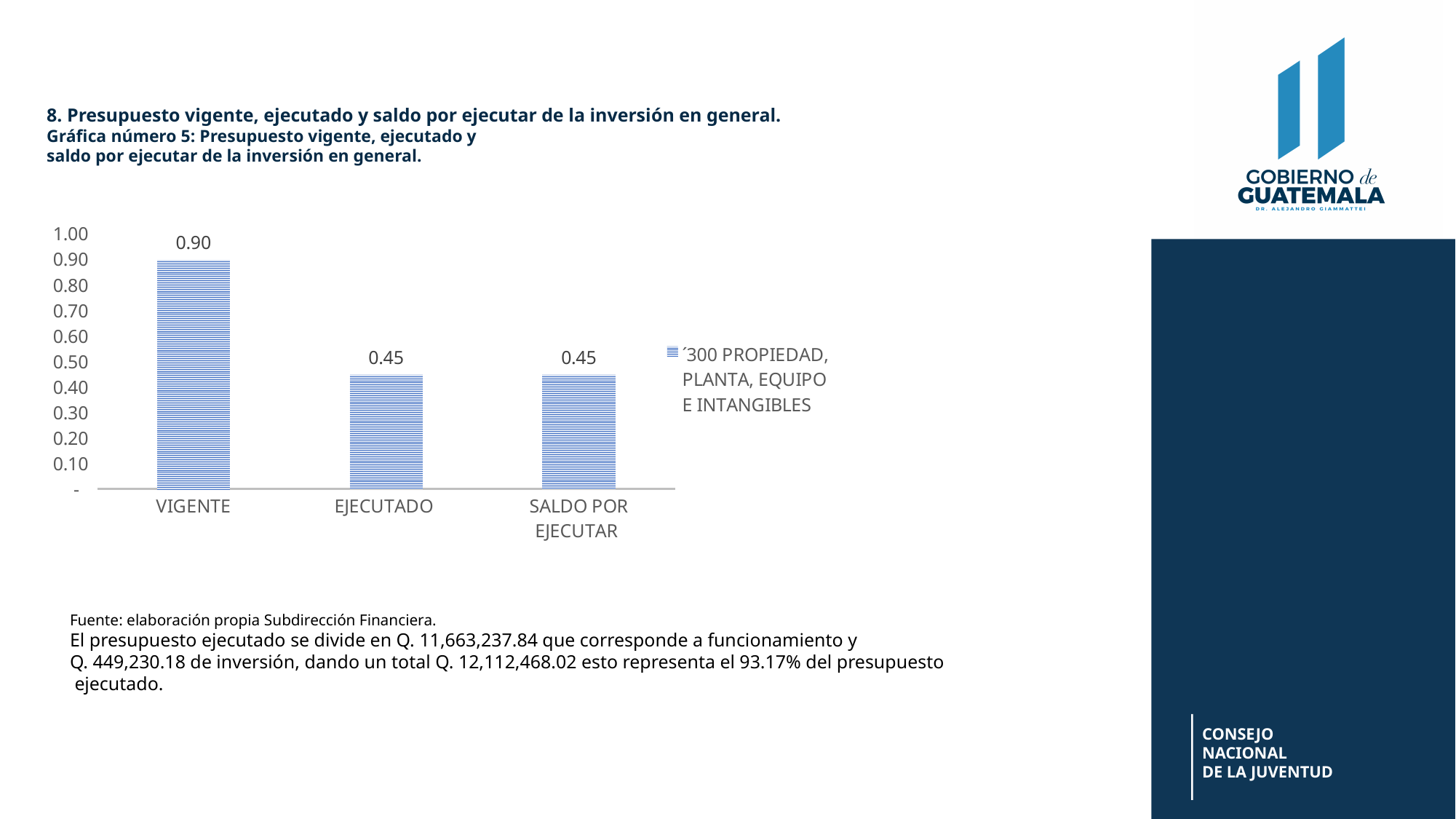
What kind of chart is shown? bar chart What is the value for VIGENTE? 0.90 Is the value for EJECUTADO greater or less than 0.50? less How many categories are shown on the x axis? 3 How many series does the legend list? 1 What is the difference between the values for VIGENTE and EJECUTADO? 0.45 What series name does the legend show? ´300 PROPIEDAD, PLANTA, EQUIPO E INTANGIBLES What is the value for EJECUTADO? 0.45 Is the value for VIGENTE greater or less than 0.80? greater Which category has the highest value? VIGENTE Which is larger, the value for VIGENTE or the value for SALDO POR EJECUTAR? VIGENTE What is the value for SALDO POR EJECUTAR? 0.45